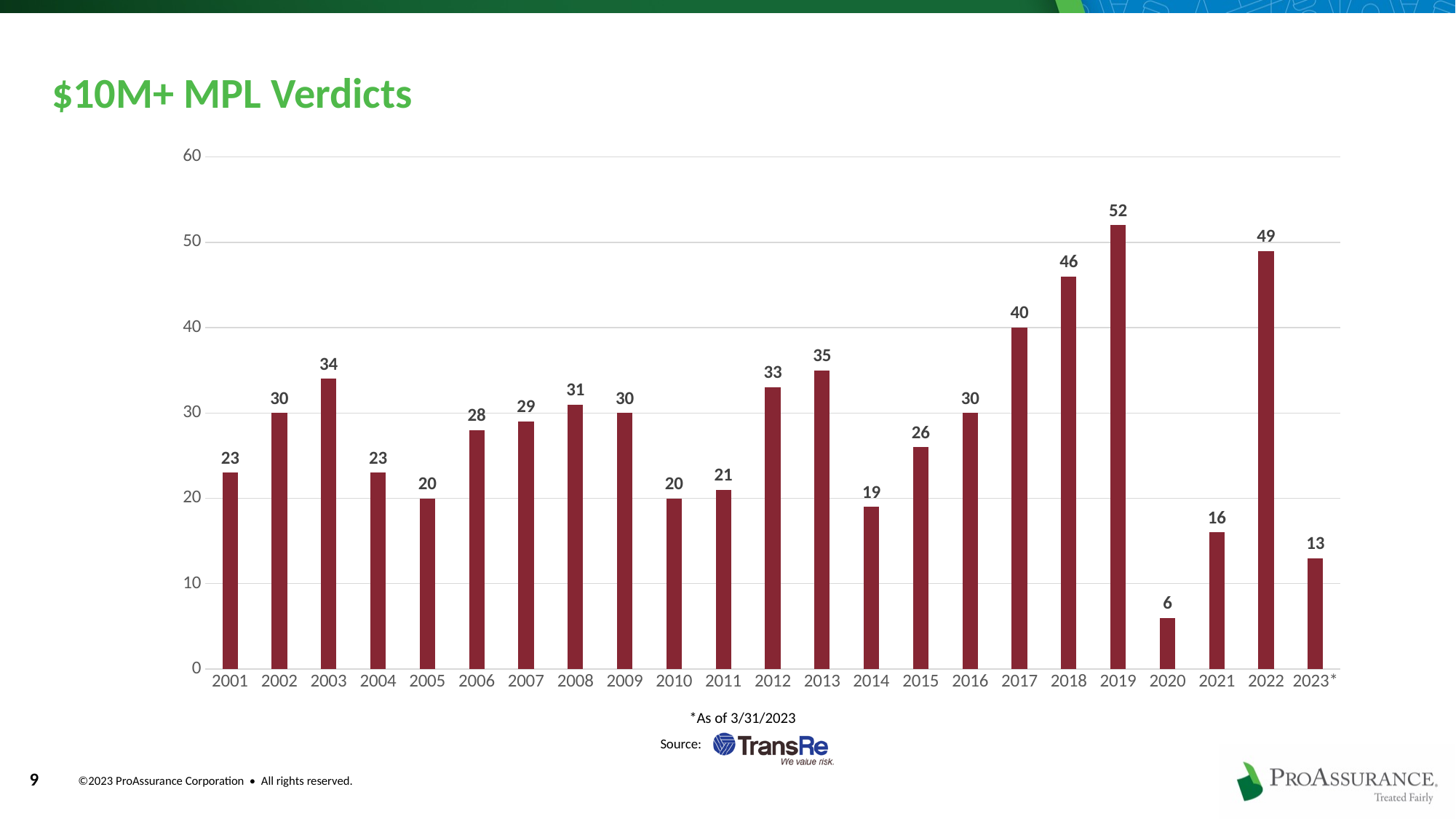
Which year has the lowest number of $10M+ MPL verdicts? 2020 What is the number of $10M+ MPL verdicts in 2019? 52 Which year has a larger value, 2003 or 2013? 2013 What kind of chart is shown on the slide? Bar chart Is the value for 2017 greater or less than 30? greater What is the value shown for 2023*? 13 What is the value shown for 2012? 33 How many years are shown on the x axis? 23 What is the difference between the values for 2022 and 2021? 33 What is the difference between the values for 2018 and 2017? 6 What is the title of the chart? $10M+ MPL Verdicts Which year has the highest number of $10M+ MPL verdicts? 2019